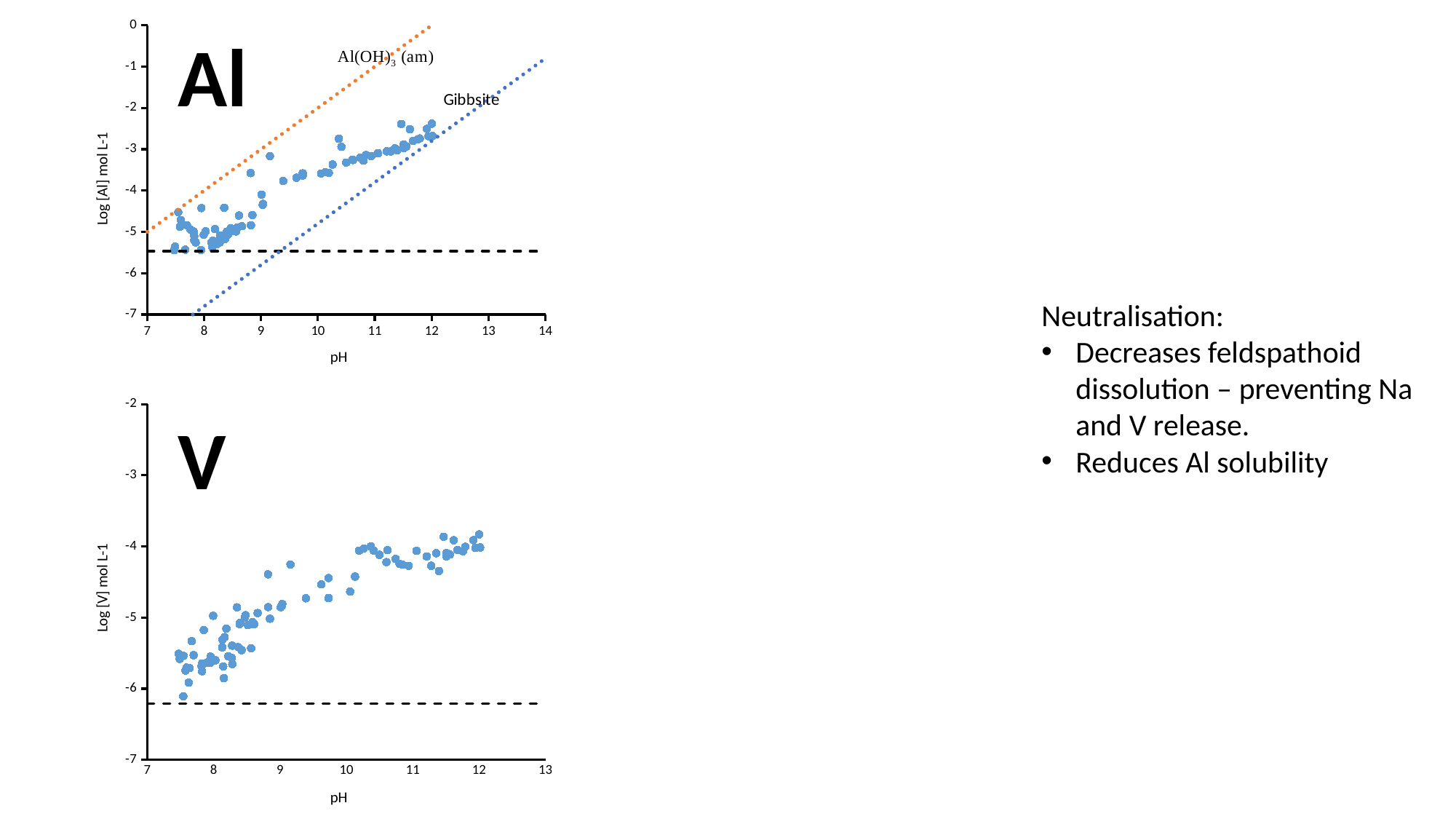
What kind of chart is the bottom chart labelled V? scatter chart In the top chart (Al), are the plotted values near pH 8 greater or less than -4? less In the bottom chart (V), are the plotted values near pH 12 greater or less than -5? greater What kind of chart is the top chart labelled Al? scatter chart In the bottom chart (V), are the plotted values near pH 7.5 greater or less than -5? less In the bottom chart (V), what is the label of the y axis? Log [V] mol L-1 In the bottom chart (V), do the plotted Log [V] values generally rise or fall as pH increases? rise How many charts are shown on the slide? 2 In the top chart (Al), do the plotted Log [Al] values generally rise or fall as pH increases from 9 to 12? rise In the top chart (Al), what is the label of the x axis? pH In the top chart (Al), what is the highest pH value shown on the x axis? 14